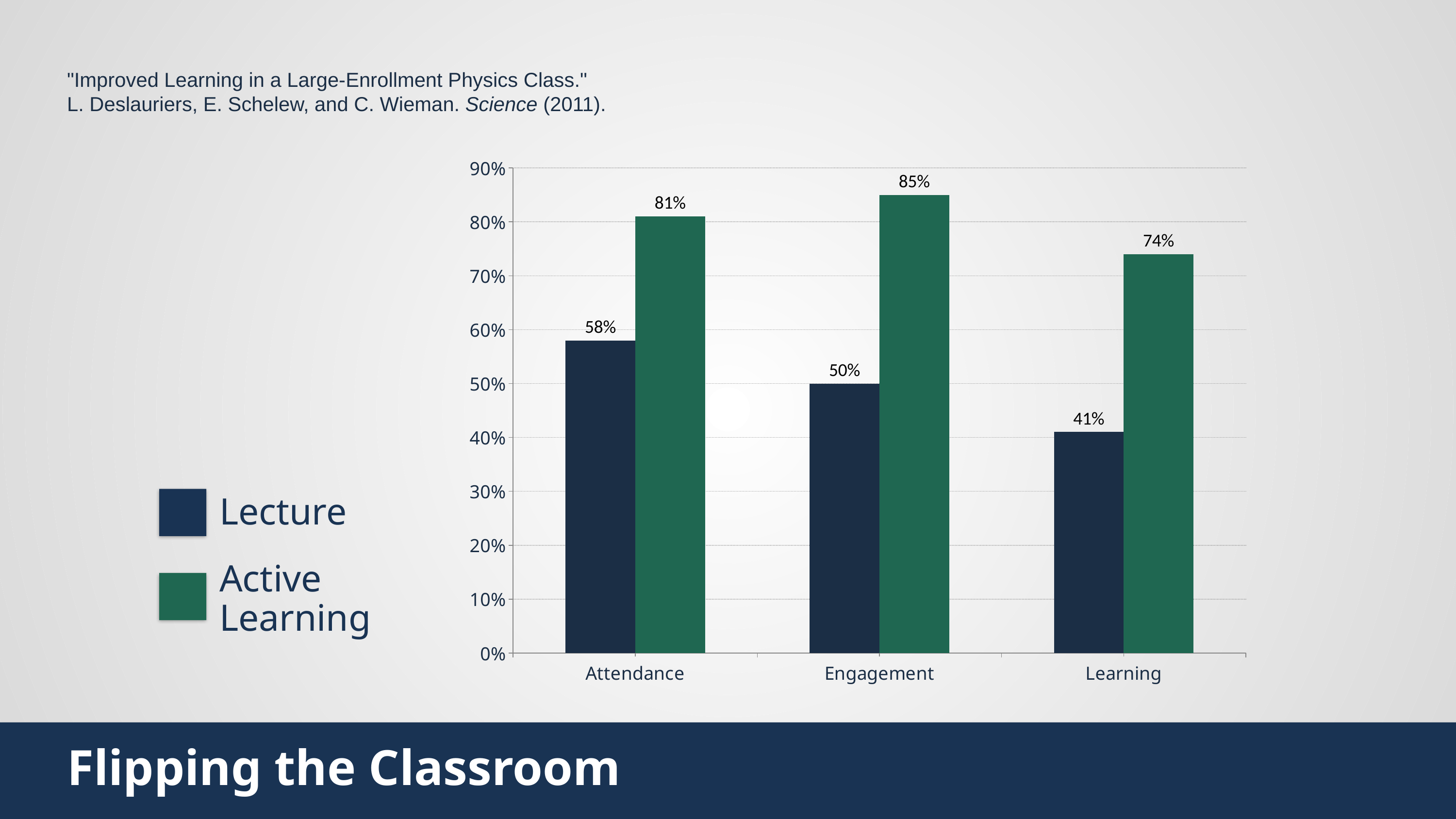
What is the difference between the Active Learning and Lecture values for Engagement? 35% What is the Lecture value for Attendance? 58% Which colour represents the Active Learning series in the legend? Green Which is larger for Attendance, the Lecture value or the Active Learning value? Active Learning Which category has the highest Active Learning value? Engagement What is the Lecture value for Learning? 41% How many series does the legend list? 2 What is the Active Learning value for Engagement? 85% Which category has the lowest Lecture value? Learning What kind of chart is shown on the slide? Bar chart What is the Active Learning value for Learning? 74% How many categories are shown on the x axis? 3